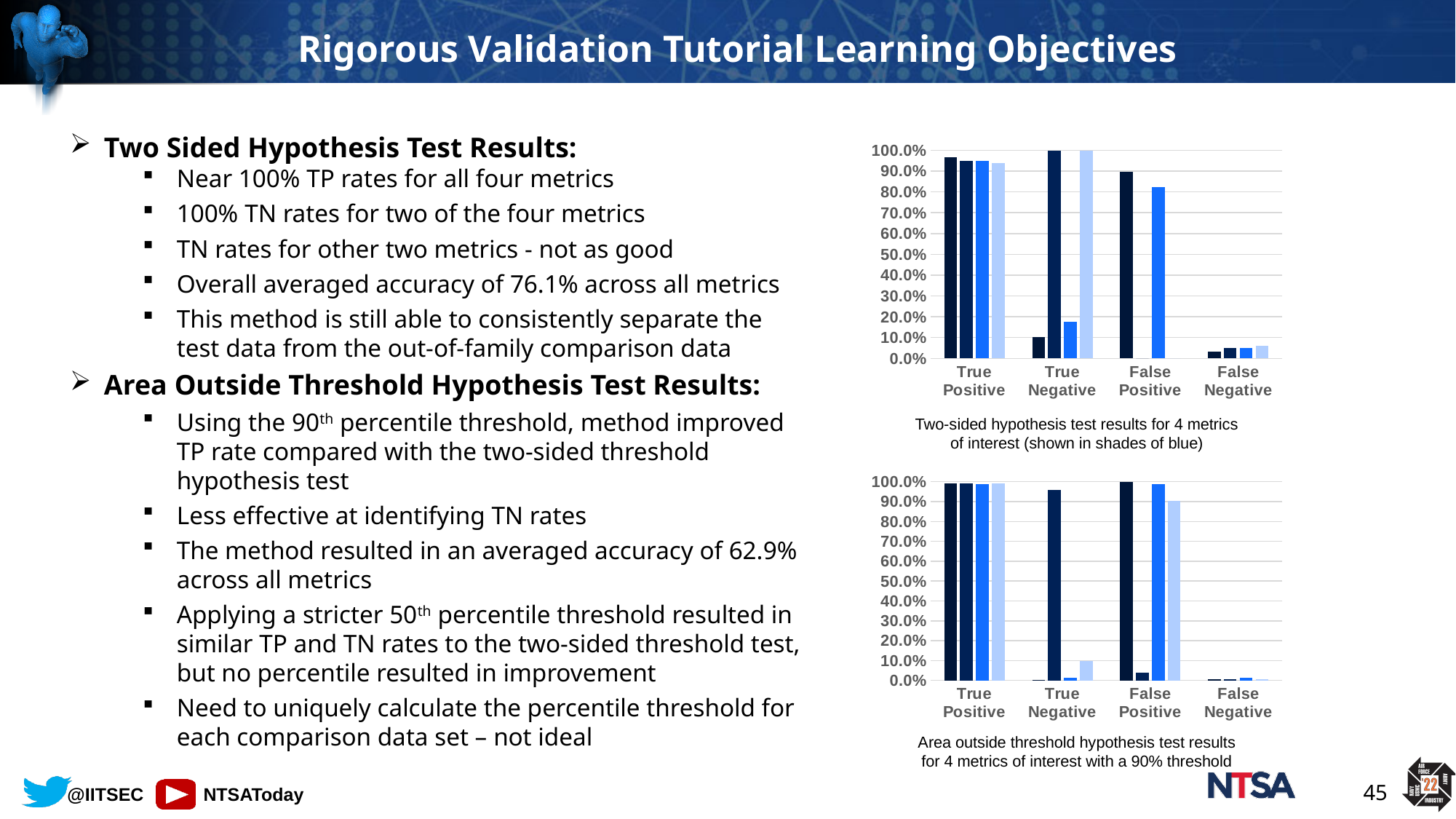
What kind of chart is the top chart on the slide? bar chart In the top chart (two-sided hypothesis test results), which category has the lowest values across all four bars? False Negative In the top chart (two-sided hypothesis test results), is the value of the first (darkest blue) bar for True Negative greater or less than 50.0%? less According to the caption of the bottom chart, what threshold was used for the area outside threshold hypothesis test? 90% threshold How many bars are plotted for each category in the bottom chart? 4 In the bottom chart (area outside threshold hypothesis test results), is the value of the fourth (lightest blue) bar for False Positive greater or less than 50.0%? greater In the top chart (two-sided hypothesis test results), is the value of the fourth (lightest blue) bar for True Negative greater or less than 90.0%? greater In the bottom chart (area outside threshold hypothesis test results), which category has the lowest values across all four bars? False Negative How many categories are shown on the x axis of the top chart? 4 In the top chart (two-sided hypothesis test results), which is larger: the first bar for True Positive or the first bar for False Negative? True Positive